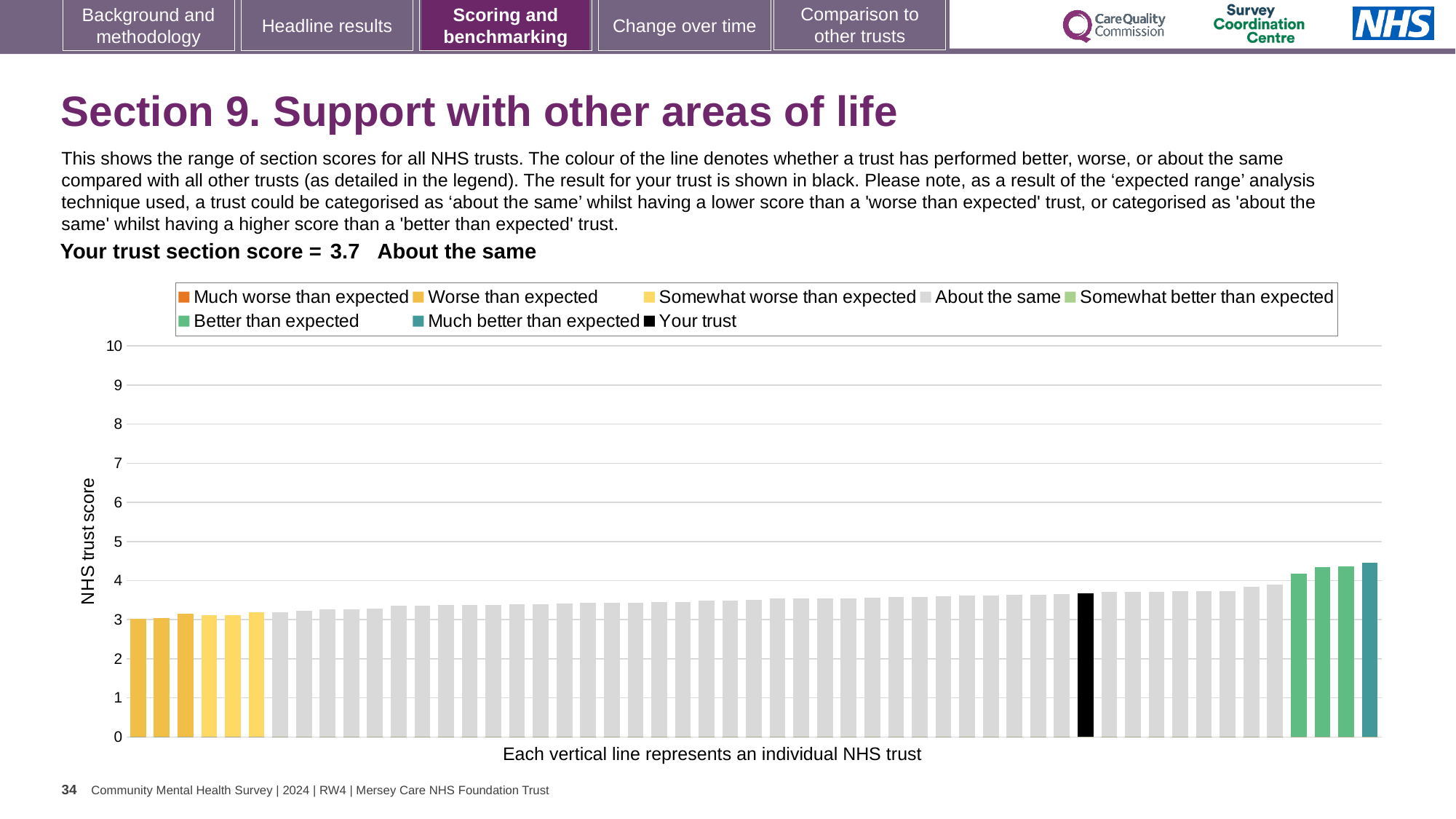
What is the section score for your trust shown on the slide? 3.7 Which performance category is your trust placed in according to the slide? About the same How many entries does the chart legend list? 8 What type of chart is shown on the slide? Bar chart What is the label on the vertical axis of the chart? NHS trust score Which legend category does the tallest bar in the chart belong to? Much better than expected Is the value for your trust (the black bar) greater or less than 3? greater How many bars are coloured as 'Better than expected' in the chart? 3 Do the bar values rise or fall moving from left to right along the x axis? Rise Is the value of the tallest bar in the chart greater or less than 4? greater How many bars are coloured as 'Worse than expected' in the chart? 3 Is the value for your trust (the black bar) greater or less than 4? less